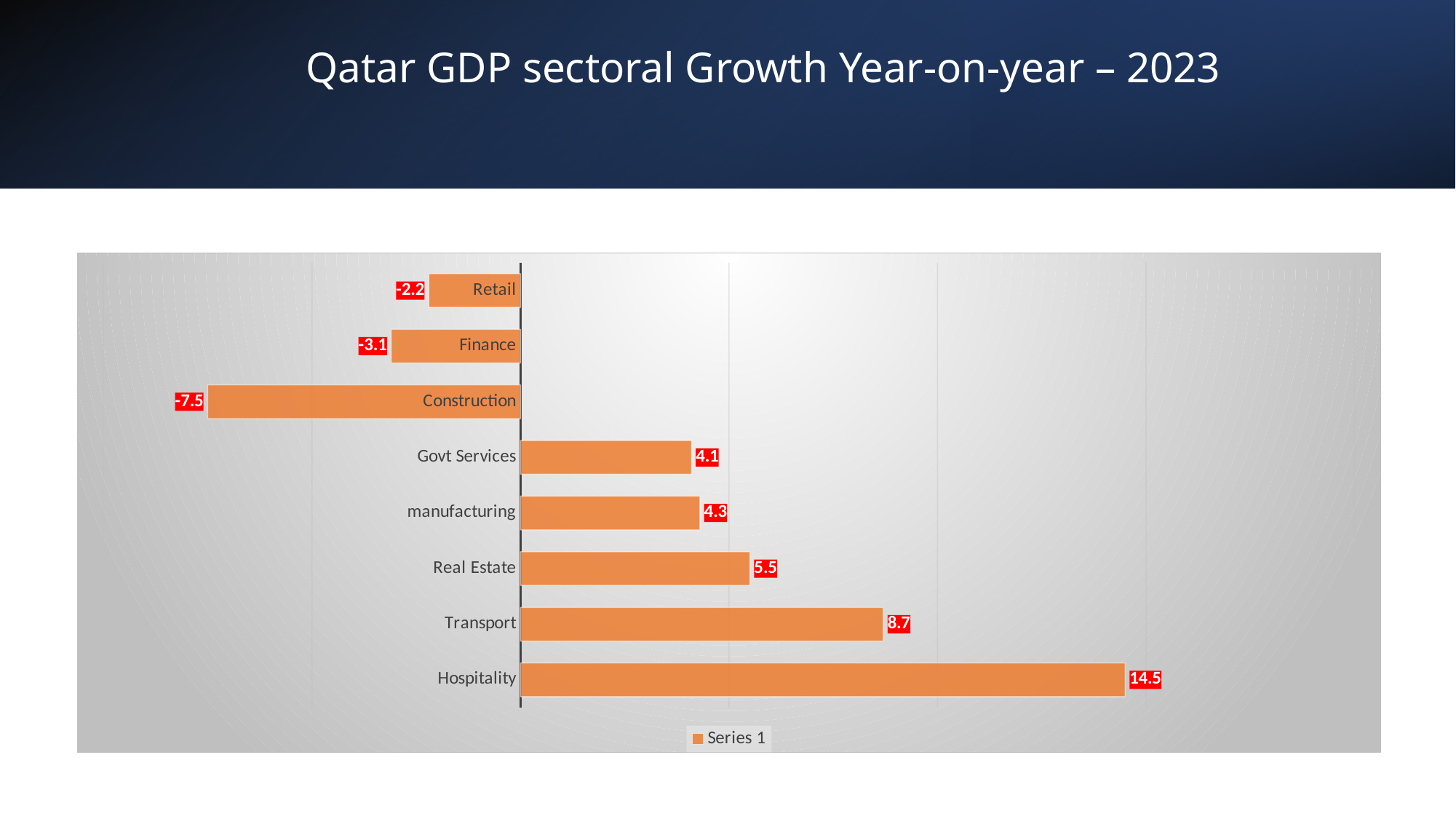
What is the difference between the values for Hospitality and Transport? 5.8 What is the value for Transport? 8.7 What is the value for Finance? -3.1 Which sector has the highest value? Hospitality What is the name of the series listed in the legend? Series 1 What is the value for Construction? -7.5 What kind of chart is shown on the slide? Bar chart What is the value for Hospitality? 14.5 How many sectors are shown in the chart? 8 Which sector has the lowest value? Construction What is the difference between the values for Real Estate and Govt Services? 1.4 Which is larger, the value for Real Estate or the value for manufacturing? Real Estate